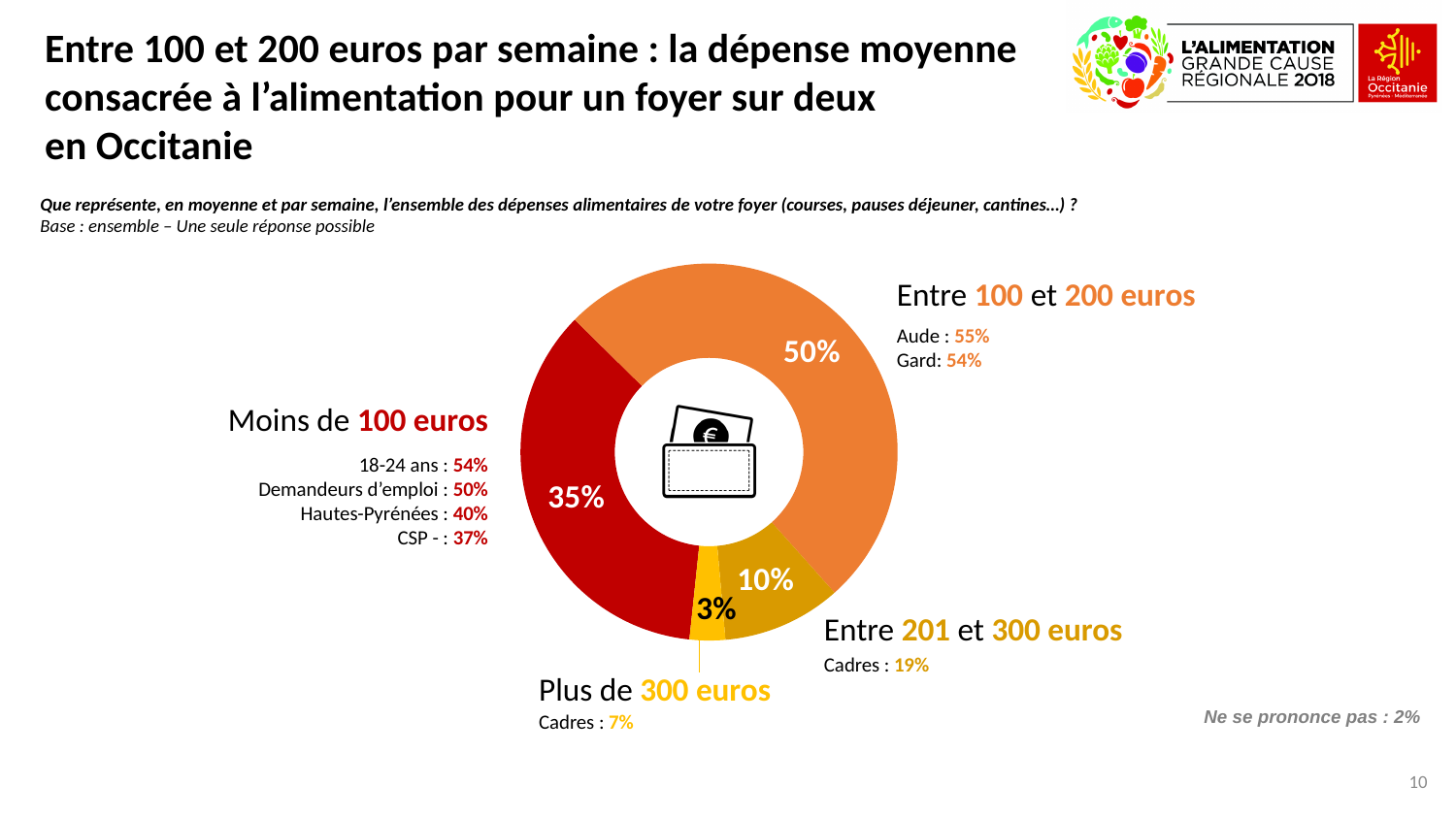
What percentage of respondents did not answer ('Ne se prononce pas')? 2% What share of households spend between 100 and 200 euros per week on food? 50% What share of households spend more than 300 euros per week? 3% Which spending category has the smallest share of the pie? Plus de 300 euros How many slices does the pie chart have? 4 Which spending category has the largest share of the pie? Entre 100 et 200 euros What share of households spend less than 100 euros per week on food? 35% What kind of chart is shown on the slide? Pie chart (donut) What colour is the 'Moins de 100 euros' slice? Red Which is larger: the share for 'Entre 201 et 300 euros' or the share for 'Plus de 300 euros'? Entre 201 et 300 euros What share of households spend between 201 and 300 euros per week? 10% What is the difference in percentage points between the 'Entre 100 et 200 euros' slice and the 'Moins de 100 euros' slice? 15 points